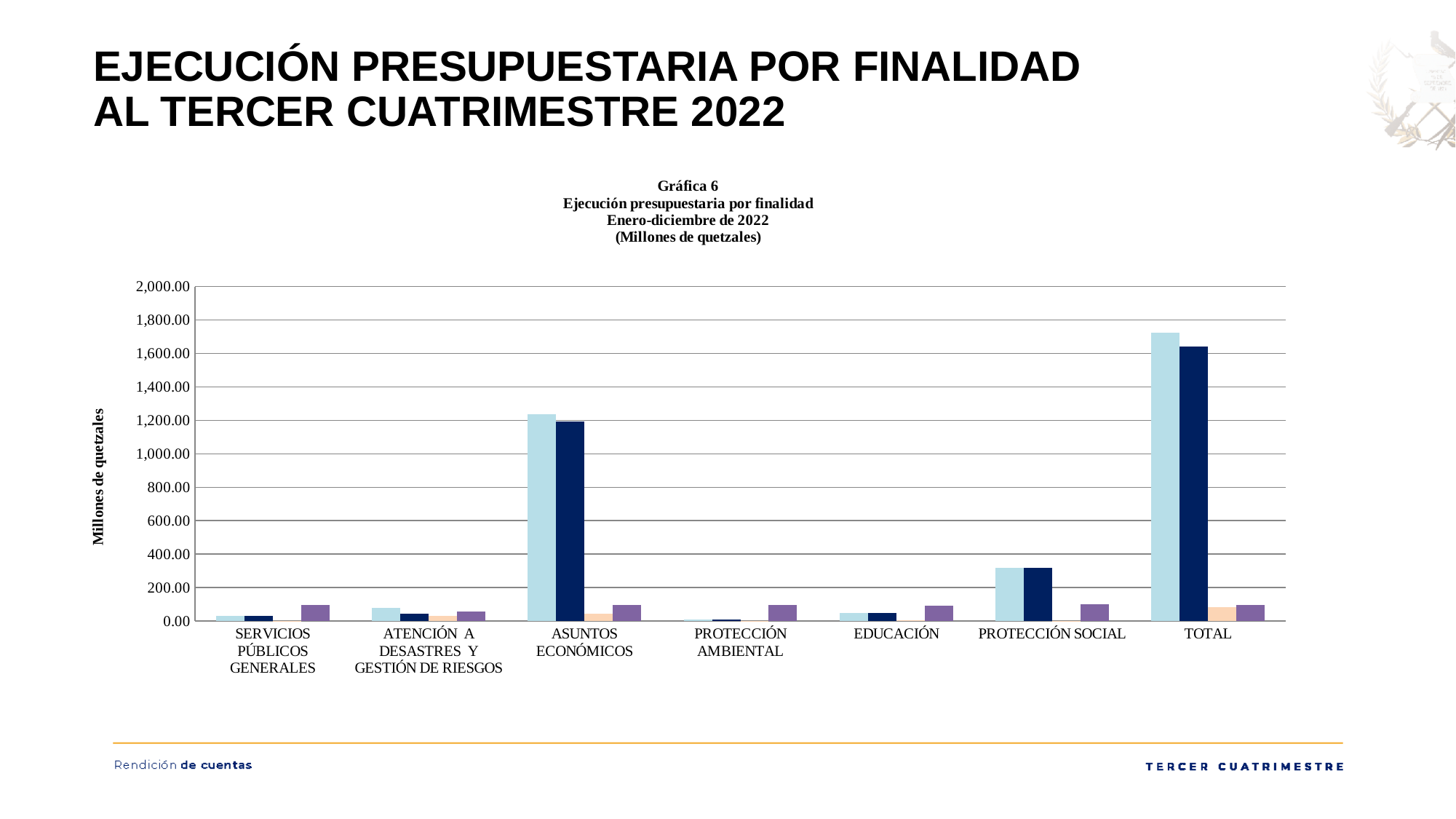
What kind of chart is shown on the slide? bar chart What is the highest value shown on the vertical axis of the chart? 2,000.00 How many categories are shown along the x axis of the chart? 7 What is the title of the vertical axis of the chart? Millones de quetzales Which category has the smallest light blue bar? PROTECCIÓN AMBIENTAL Is the light blue bar for TOTAL greater or less than 1,600.00? greater Excluding TOTAL, which category has the tallest dark navy bar? ASUNTOS ECONÓMICOS Which category has the tallest light blue bar? TOTAL Is the dark navy bar for ASUNTOS ECONÓMICOS greater or less than 1,000.00? greater Is the light blue bar for ASUNTOS ECONÓMICOS greater or less than 1,400.00? less For TOTAL, which is taller: the light blue bar or the dark navy bar? the light blue bar